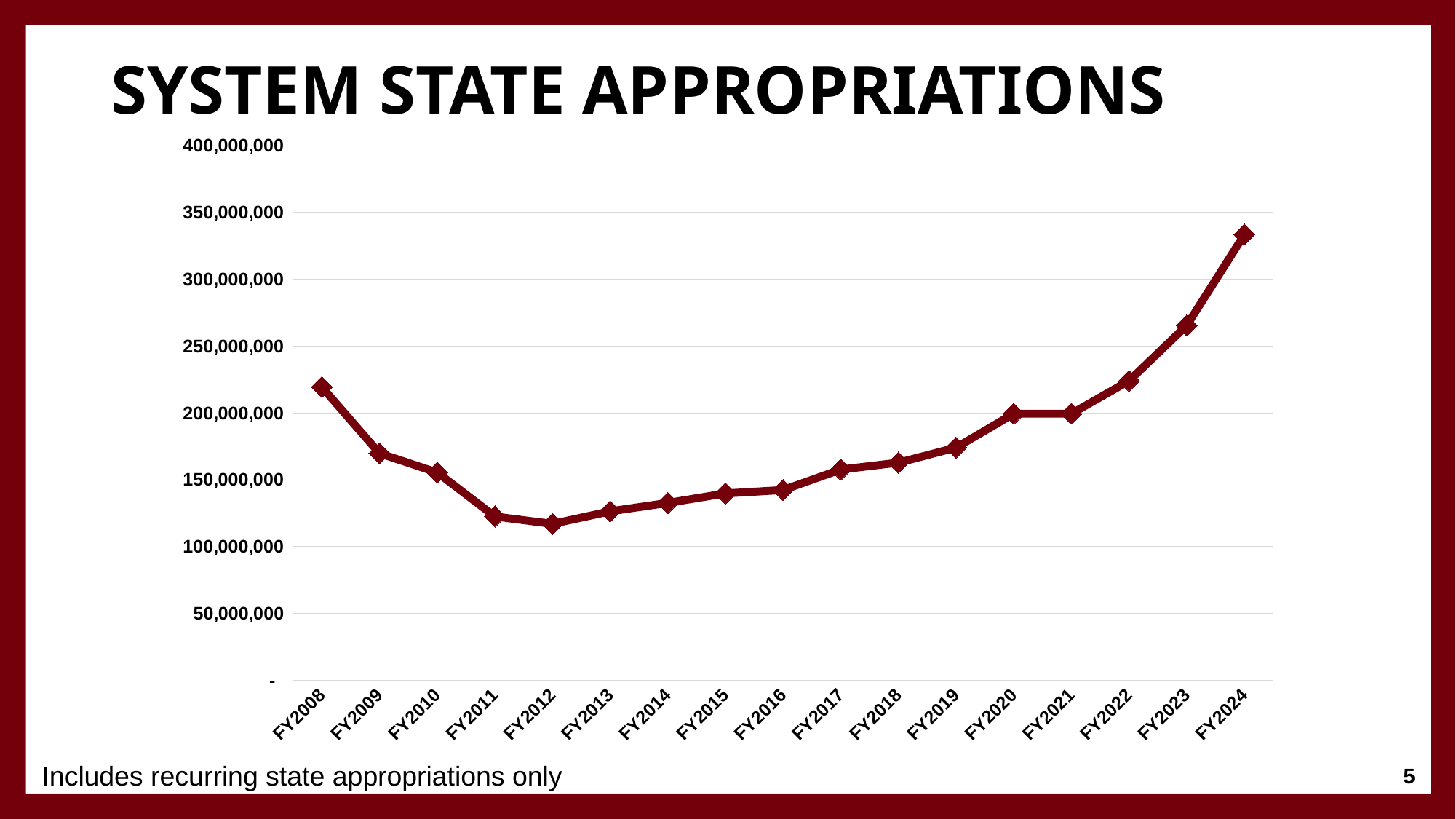
Which fiscal year has the lowest system state appropriations? FY2012 How many fiscal years are plotted on the chart? 17 Which is larger, the value for FY2008 or the value for FY2023? FY2023 Is the value for FY2011 greater or less than 150,000,000? less What is the title of the chart? SYSTEM STATE APPROPRIATIONS What kind of chart is shown on the slide? line chart Is the value for FY2012 greater or less than 100,000,000? greater Is the value for FY2023 greater or less than 250,000,000? greater Do the values rise or fall from FY2012 to FY2024? rise Which is larger, the value for FY2011 or the value for FY2015? FY2015 Which fiscal year has the highest system state appropriations? FY2024